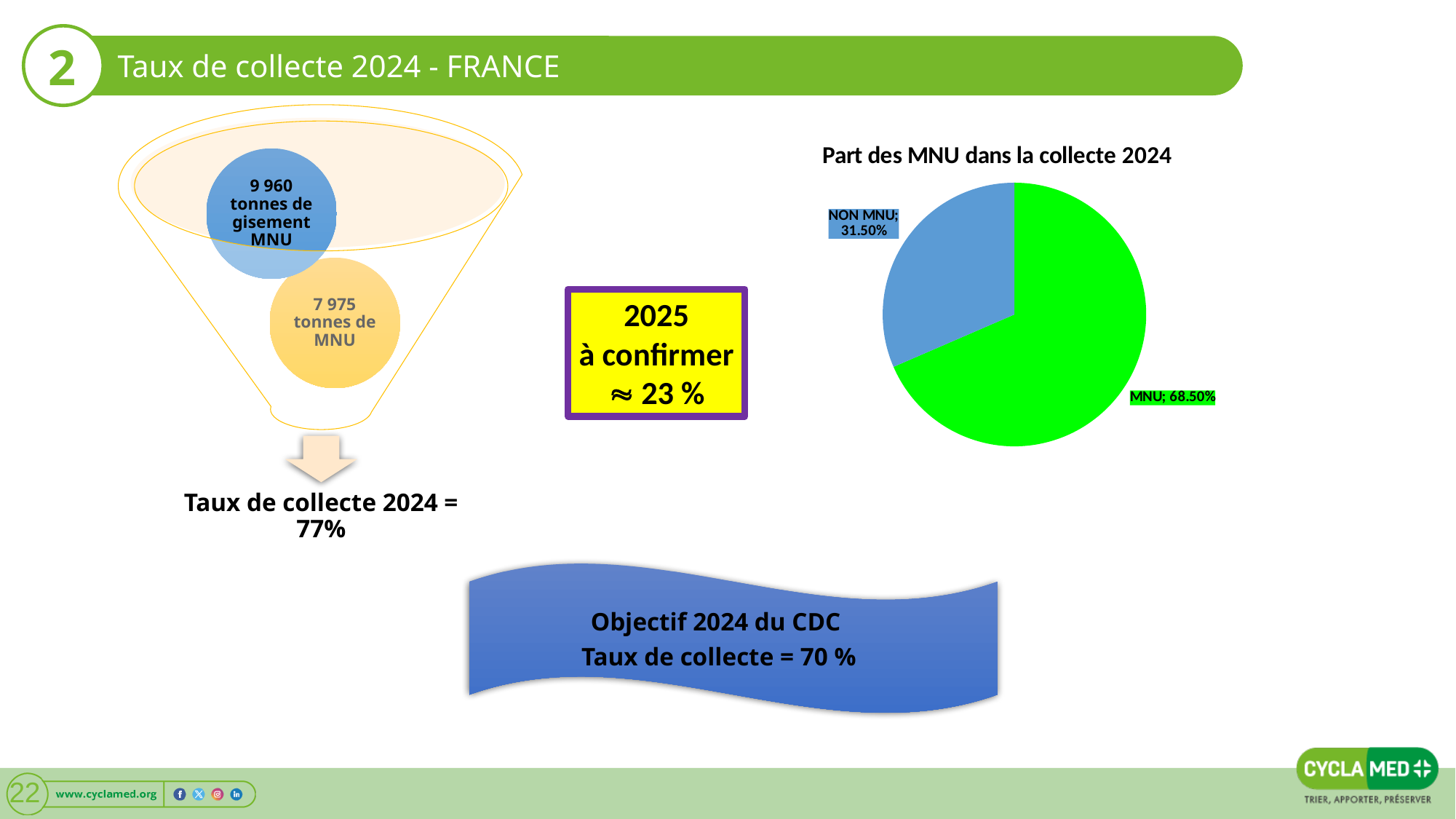
In the pie chart, which slice is the smallest? NON MNU In the pie chart, which slice is the largest? MNU In the pie chart, what is the share for MNU? 68.50% In the pie chart, what is the difference in percentage points between the MNU and NON MNU shares? 37 percentage points How many slices does the pie chart have? 2 In the pie chart, is the share for NON MNU greater or less than 50%? less In the pie chart, what is the share for NON MNU? 31.50% In the pie chart, what colour is the MNU slice? green What is the title of the pie chart on the slide? Part des MNU dans la collecte 2024 In the pie chart, which is larger: MNU or NON MNU? MNU What kind of chart is shown under the title 'Part des MNU dans la collecte 2024'? pie chart